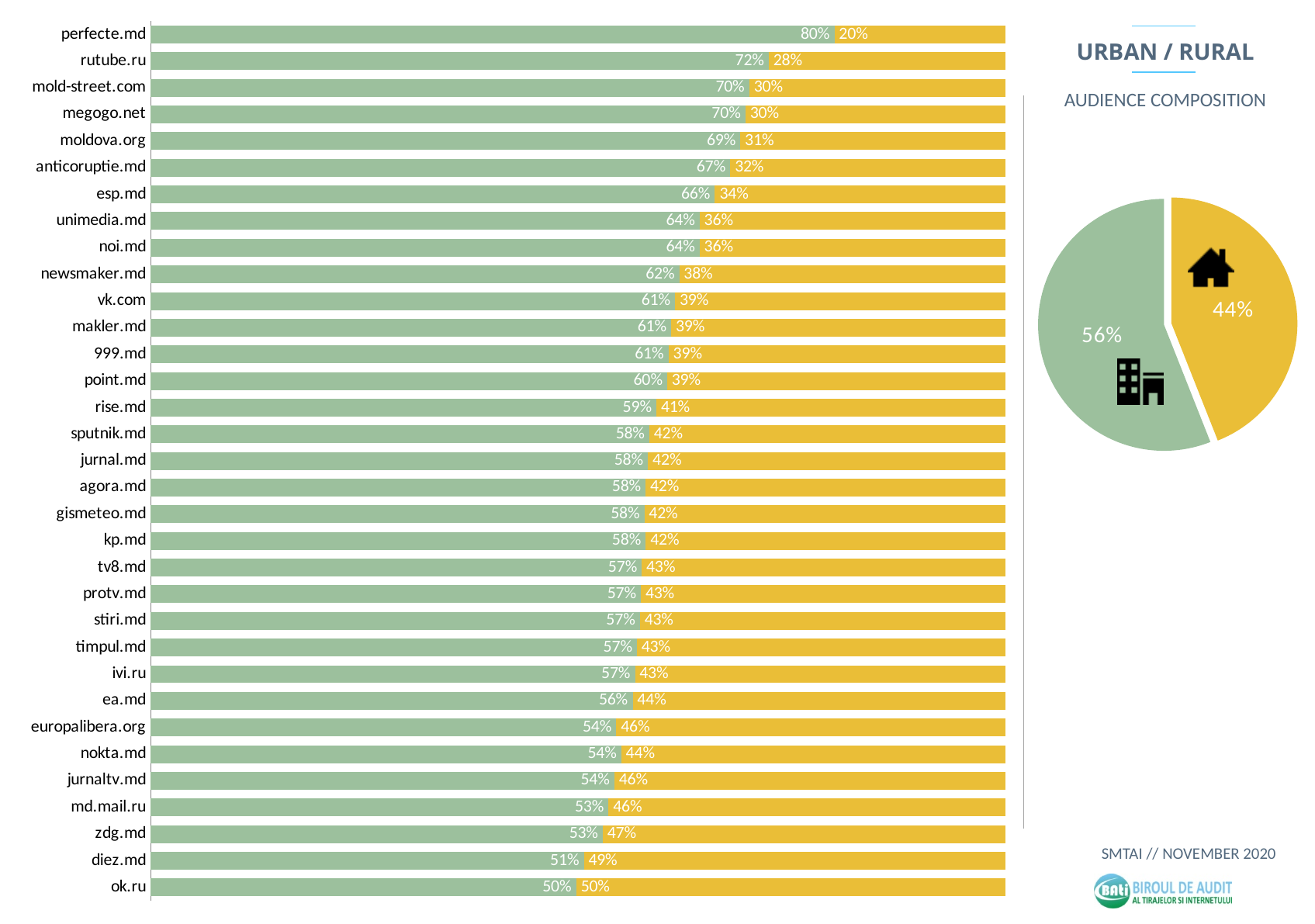
What kind of chart is the large chart on the left of the slide? Bar chart In the bar chart, what is the value printed on the yellow segment for zdg.md? 47% In the bar chart, which site has the smallest green segment? ok.ru In the bar chart, what is the value printed on the yellow segment for ok.ru? 50% In the pie chart, which slice is larger, the green one or the yellow one? The green one (56%) In the bar chart, what is the difference between the green values for perfecte.md and rutube.ru? 8 percentage points What is the title shown at the top right of the slide? URBAN / RURAL How many sites are listed in the bar chart? 33 In the pie chart, what share is shown for the green (urban) slice? 56% In the bar chart, which site has a larger green value, moldova.org or esp.md? moldova.org In the bar chart, which site has the largest green segment? perfecte.md In the bar chart, what is the value printed on the green segment for perfecte.md? 80%